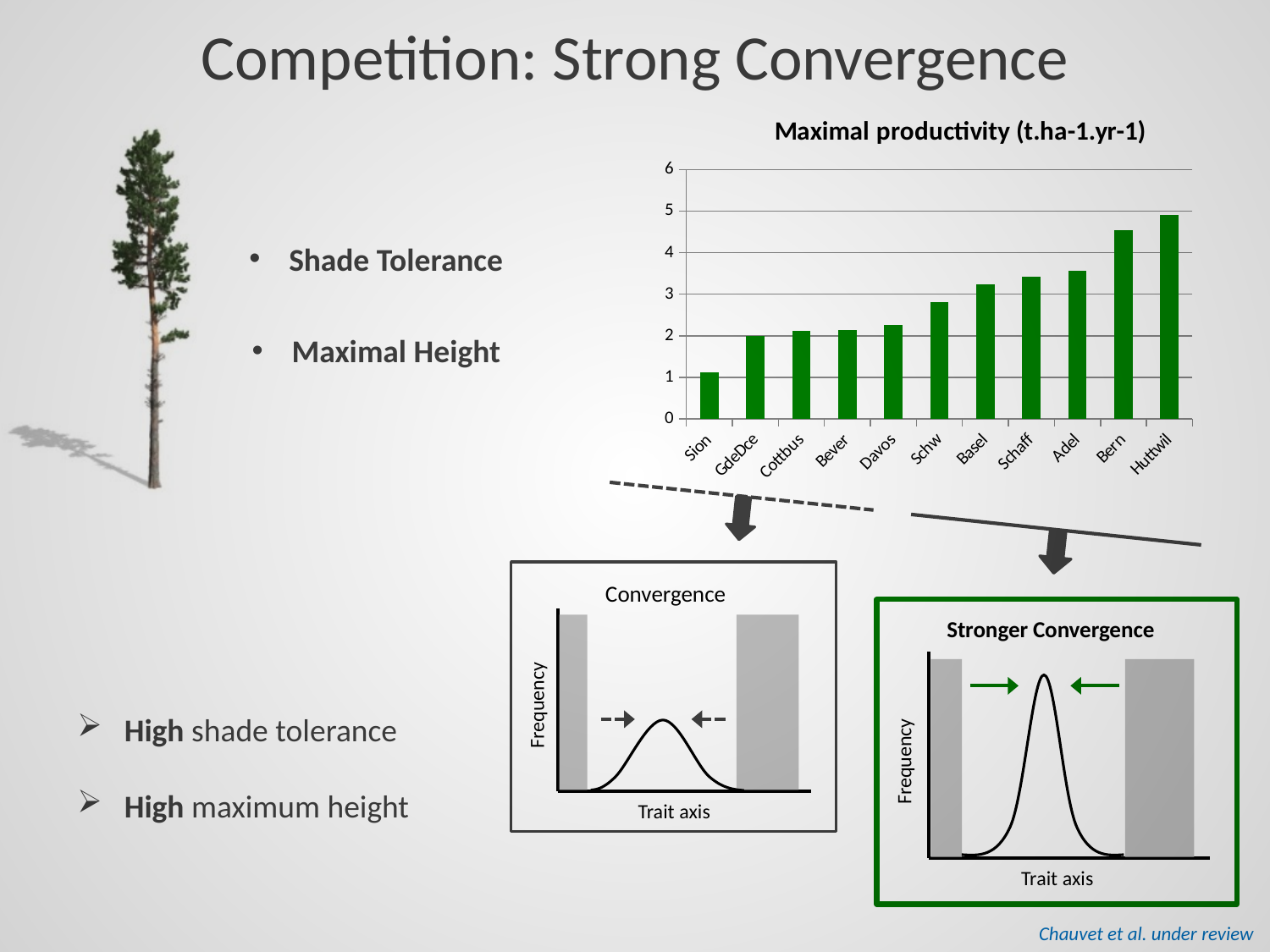
In the 'Maximal productivity (t.ha-1.yr-1)' chart, which site has the highest value? Huttwil How many sites are shown on the x axis of the 'Maximal productivity (t.ha-1.yr-1)' chart? 11 What kind of chart is the 'Maximal productivity (t.ha-1.yr-1)' chart? bar chart In the 'Maximal productivity (t.ha-1.yr-1)' chart, is the value for Davos greater or less than 3? less In the 'Maximal productivity (t.ha-1.yr-1)' chart, is the value for Bern greater or less than 4? greater In the 'Maximal productivity (t.ha-1.yr-1)' chart, which is larger, the value for Schw or the value for Adel? Adel In the 'Maximal productivity (t.ha-1.yr-1)' chart, do the values rise or fall from left to right along the x axis? rise In the 'Maximal productivity (t.ha-1.yr-1)' chart, which is larger, the value for Bern or the value for Sion? Bern What is the title of the bar chart on the slide? Maximal productivity (t.ha-1.yr-1) In the 'Maximal productivity (t.ha-1.yr-1)' chart, is the value for Huttwil greater or less than 4? greater In the 'Maximal productivity (t.ha-1.yr-1)' chart, which site has the lowest value? Sion